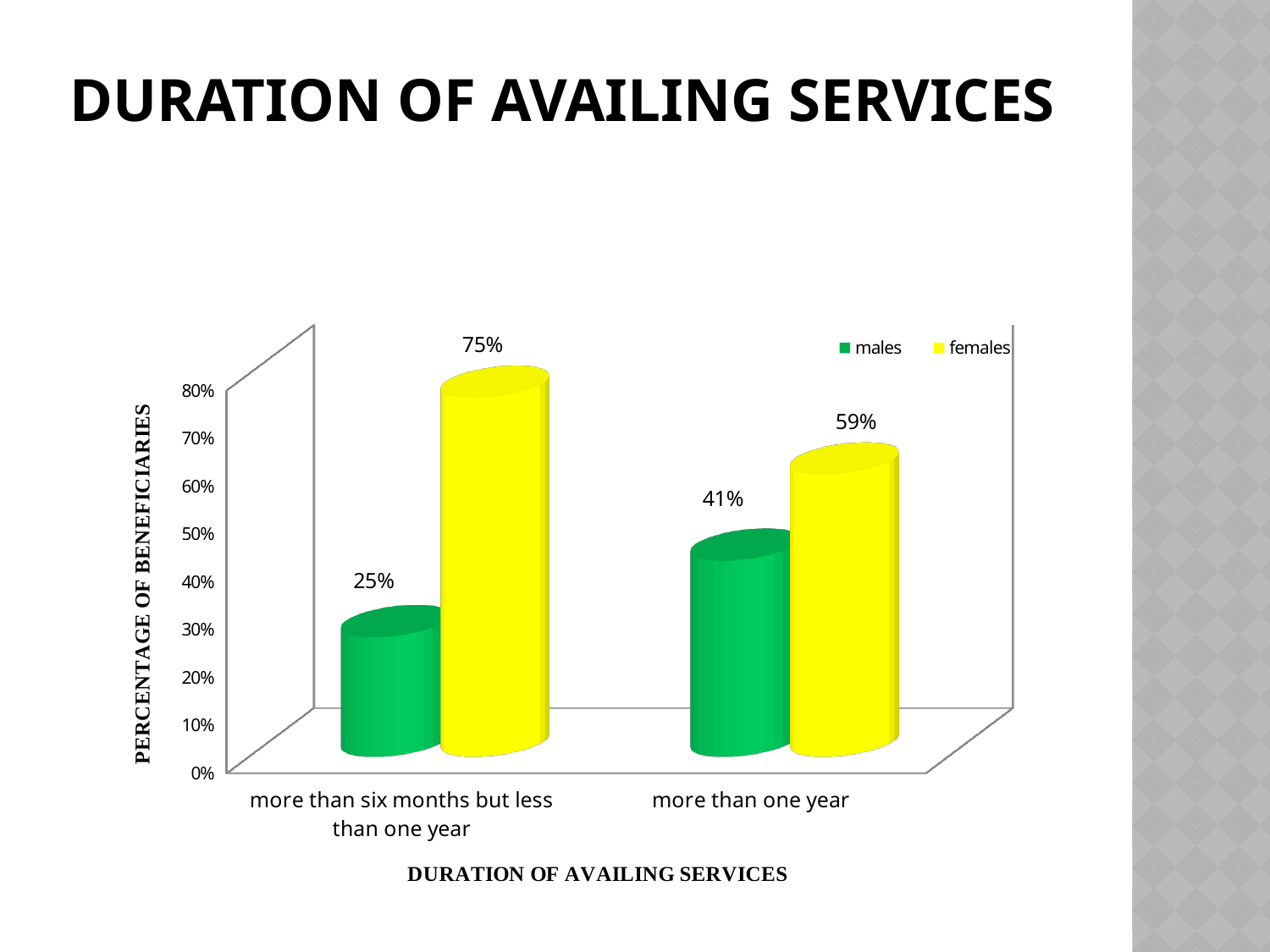
How many series does the legend list? 2 What percentage of males availed services for more than one year? 41% What percentage of females availed services for more than six months but less than one year? 75% How many duration categories are shown on the x axis? 2 What percentage of males availed services for more than six months but less than one year? 25% Which is larger: the male percentage for more than one year or the male percentage for more than six months but less than one year? more than one year What percentage of females availed services for more than one year? 59% Which series has the highest value on the chart? females What is the difference between the female percentages for the two duration categories? 16% Which bar shows the lowest value on the chart? males, more than six months but less than one year What is the difference between the female and male percentages for more than six months but less than one year? 50% What kind of chart is shown on the slide? bar chart